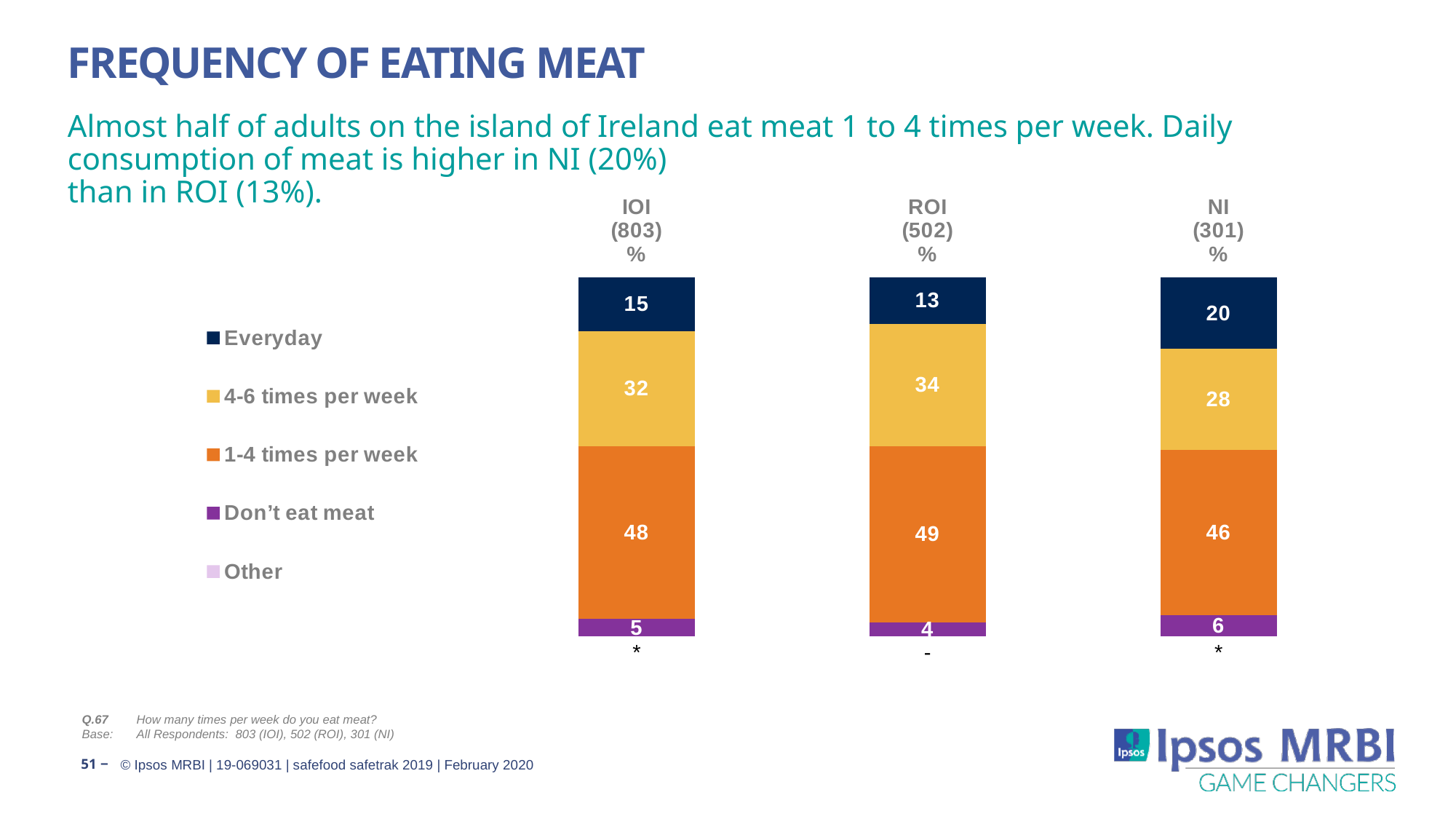
What percentage of ROI respondents don't eat meat? 4 Which region has the lowest percentage eating meat 4-6 times per week? NI What type of chart is shown on the slide? Stacked bar chart Which region has the highest percentage eating meat every day? NI How many categories does the legend list? 5 Is the percentage eating meat 1-4 times per week higher in ROI or in NI? ROI What is the base (number of respondents) for the NI bar? 301 What percentage of ROI respondents eat meat 4-6 times per week? 34 How many regions (bars) are shown in the chart? 3 What is the difference between the NI and ROI percentages for eating meat every day? 7 What percentage of IOI respondents eat meat 1-4 times per week? 48 What percentage of NI respondents eat meat every day? 20